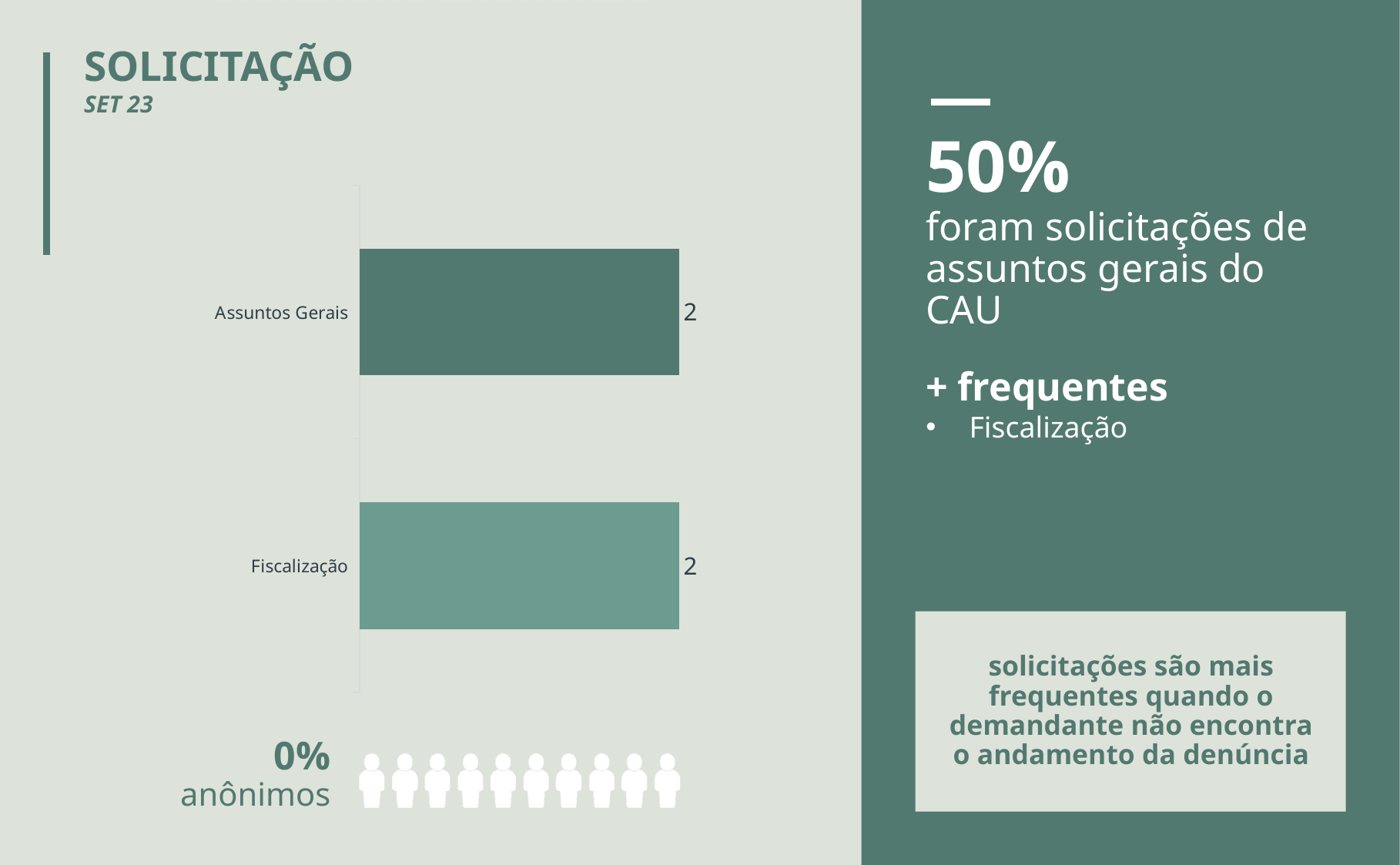
Which category is listed at the top of the bar chart? Assuntos Gerais What kind of chart is shown on the slide? bar chart What is the value for Assuntos Gerais? 2 What is the total of the values for Assuntos Gerais and Fiscalização? 4 What is the difference between the values for Assuntos Gerais and Fiscalização? 0 What is the value for Fiscalização? 2 Are the bars in the chart horizontal or vertical? horizontal Do the values for Assuntos Gerais and Fiscalização differ? No, both are 2 How many categories does the bar chart show? 2